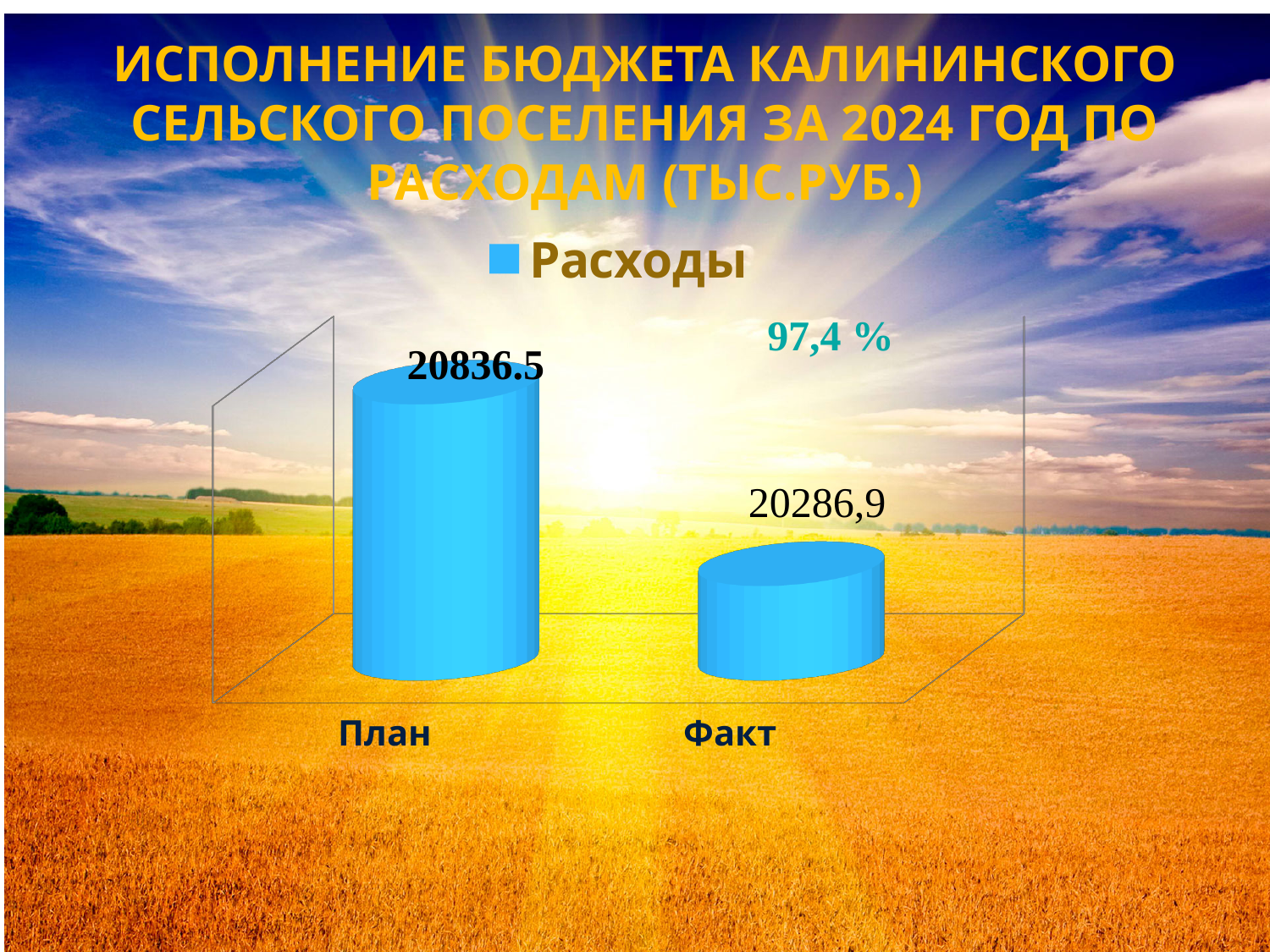
What is the value for Факт? 20286,9 Which category has the highest value? План How many series does the legend list? 1 What is the difference between the value for План and the value for Факт? 549.6 Do the values rise or fall from План to Факт? fall What series name is shown in the legend? Расходы Which category has the lowest value? Факт Which is larger, the value for План or the value for Факт? План What kind of chart is shown on the slide? bar chart How many categories are shown on the x axis? 2 What percentage is printed above the Факт bar? 97,4 % What is the value for План? 20836.5